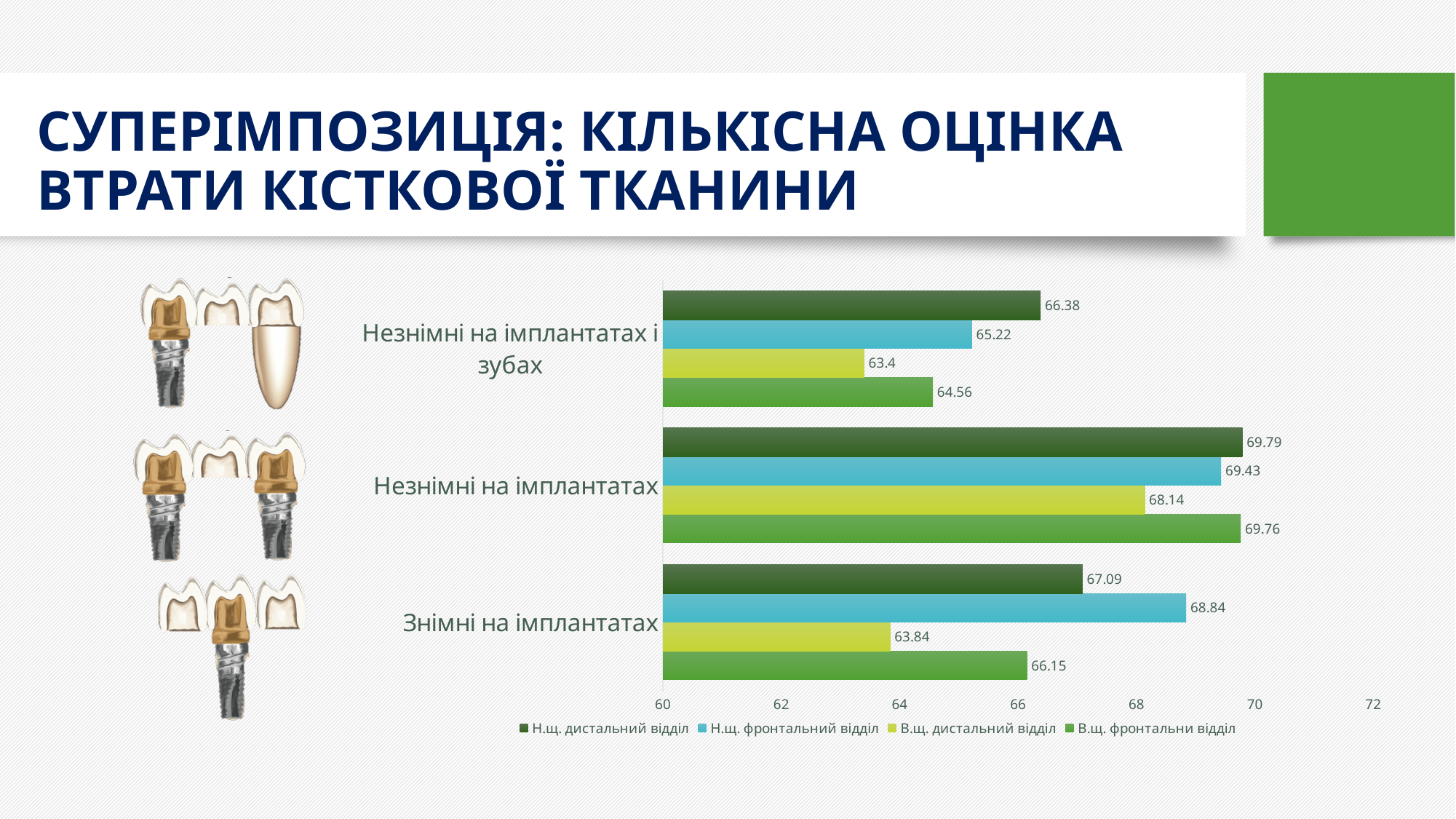
Which is larger: the Н.щ. дистальний відділ value for Незнімні на імплантатах і зубах or for Знімні на імплантатах? Знімні на імплантатах How many series does the legend list? 4 How many categories are shown on the chart? 3 What is the difference between the Н.щ. фронтальний відділ and В.щ. дистальний відділ values for Знімні на імплантатах? 5 Which series has the lowest value for Незнімні на імплантатах? В.щ. дистальний відділ What is the value of В.щ. фронтальни відділ for Незнімні на імплантатах і зубах? 64.56 What is the value of Н.щ. дистальний відділ for Незнімні на імплантатах і зубах? 66.38 What kind of chart is shown on the slide? bar chart What is the value of Н.щ. фронтальний відділ for Незнімні на імплантатах? 69.43 Which series has the highest value for Знімні на імплантатах? Н.щ. фронтальний відділ What is the value of В.щ. дистальний відділ for Знімні на імплантатах? 63.84 Is the Н.щ. дистальний відділ value for Незнімні на імплантатах greater or less than 68? greater